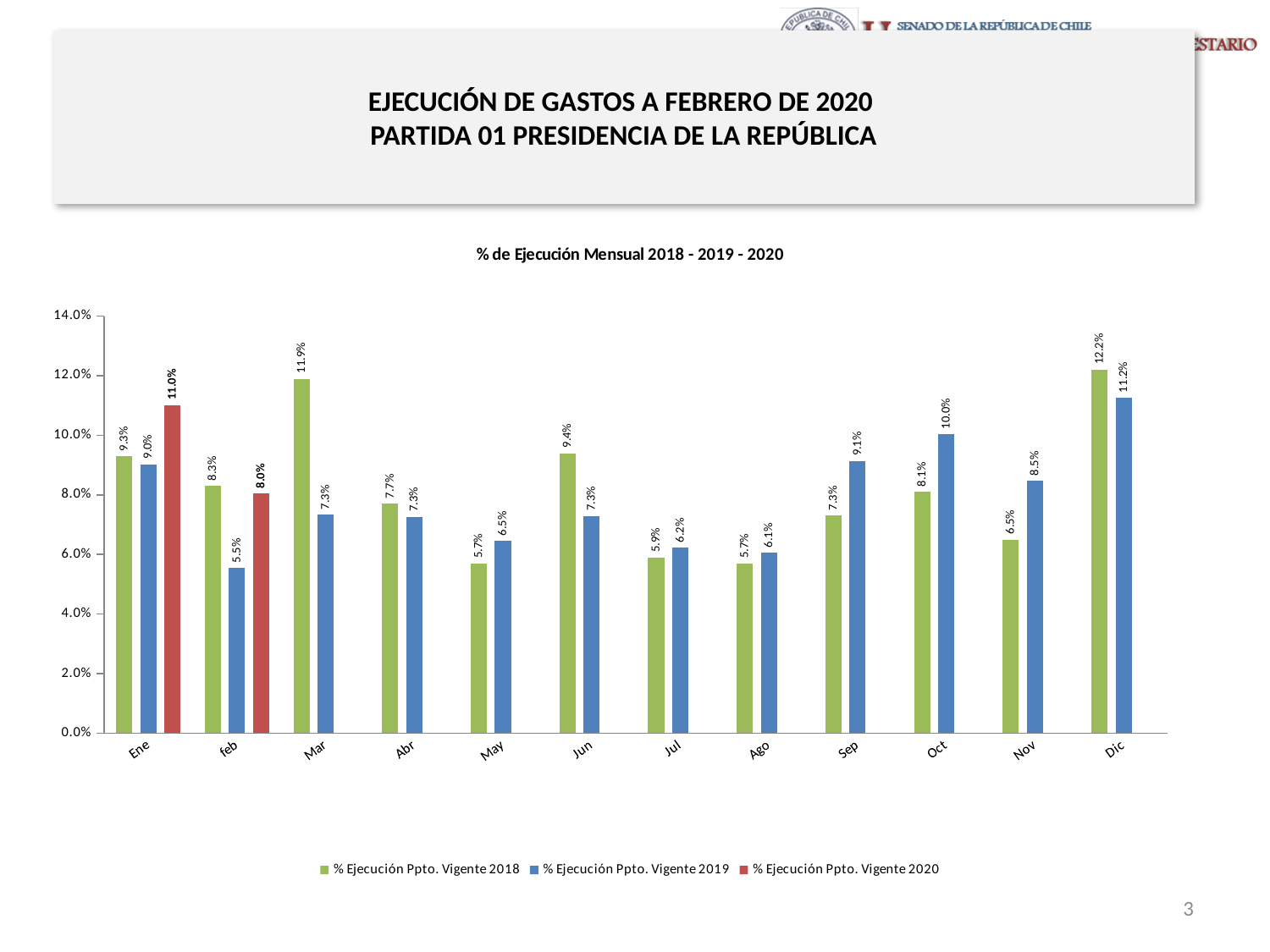
Which month has the lowest value for % Ejecución Ppto. Vigente 2019? feb What is the value for % Ejecución Ppto. Vigente 2019 in feb? 5.5% How many series does the legend list? 3 What is the title of the chart? % de Ejecución Mensual 2018 - 2019 - 2020 What is the difference between the 2018 and 2019 values in Oct? 1.9% What is the value for % Ejecución Ppto. Vigente 2020 in Ene? 11.0% What is the value for % Ejecución Ppto. Vigente 2018 in Mar? 11.9% What kind of chart is shown on the slide? Bar chart In Sep, which series is larger: % Ejecución Ppto. Vigente 2018 or % Ejecución Ppto. Vigente 2019? % Ejecución Ppto. Vigente 2019 Is the value for % Ejecución Ppto. Vigente 2019 in Dic greater or less than 10.0%? greater How many months are shown on the x axis? 12 Which month has the highest value for % Ejecución Ppto. Vigente 2018? Dic